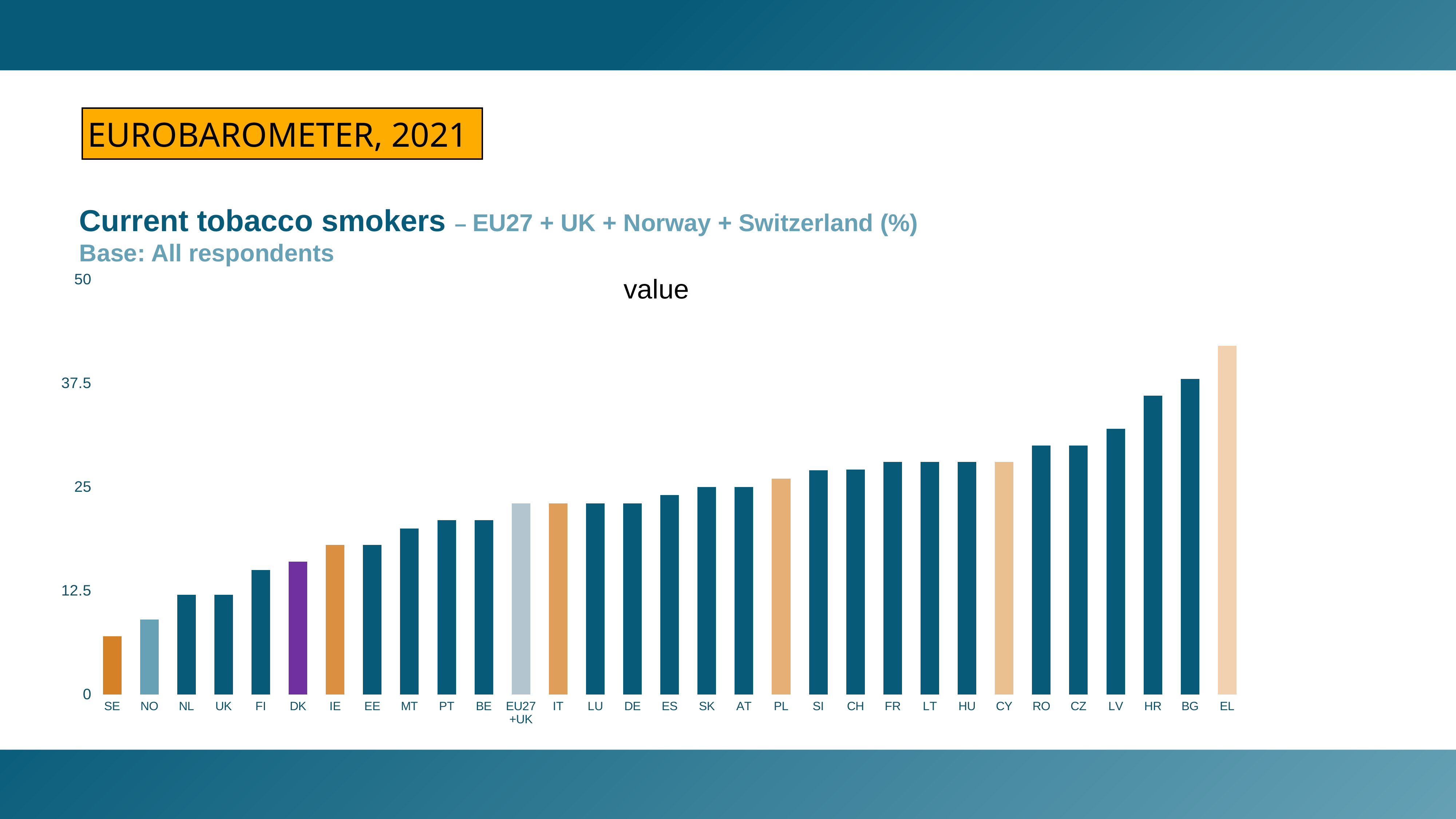
How many categories are plotted along the x axis? 31 Is the value for IT greater or less than 25? less Which category has the lowest value in the chart? SE Is the value for SE greater or less than 12.5? less What kind of chart is shown on the slide? bar chart Is the value for RO greater or less than 25? greater What is the title of the chart? value Which category has the highest value in the chart? EL Do the values generally rise or fall moving from left to right along the x axis? rise Which has the larger value, DK or IE? IE